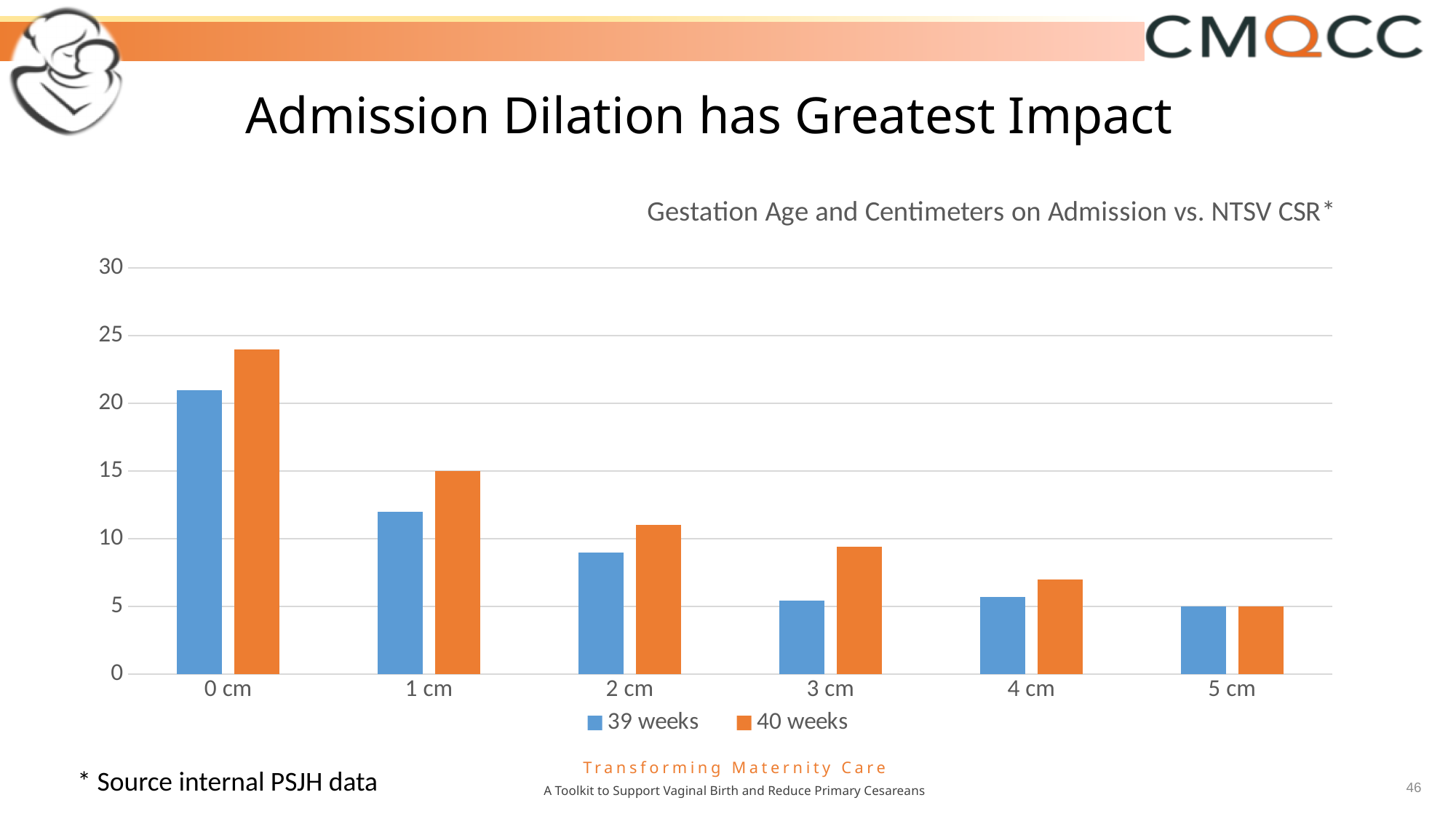
At 0 cm, which series has the larger value, 39 weeks or 40 weeks? 40 weeks Is the value for 39 weeks at 1 cm greater or less than 10? greater What is the title of the chart? Gestation Age and Centimeters on Admission vs. NTSV CSR* How many series does the legend list? 2 What kind of chart is shown on the slide? bar chart Which dilation category has the highest value for the 40 weeks series? 0 cm Is the value for 40 weeks at 4 cm greater or less than 10? less How many dilation categories are shown on the x axis? 6 Is the value for 39 weeks at 0 cm greater or less than 20? greater Do the values for the 40 weeks series generally rise or fall as dilation increases from 0 cm to 5 cm? fall Which dilation category has the lowest value for the 40 weeks series? 5 cm